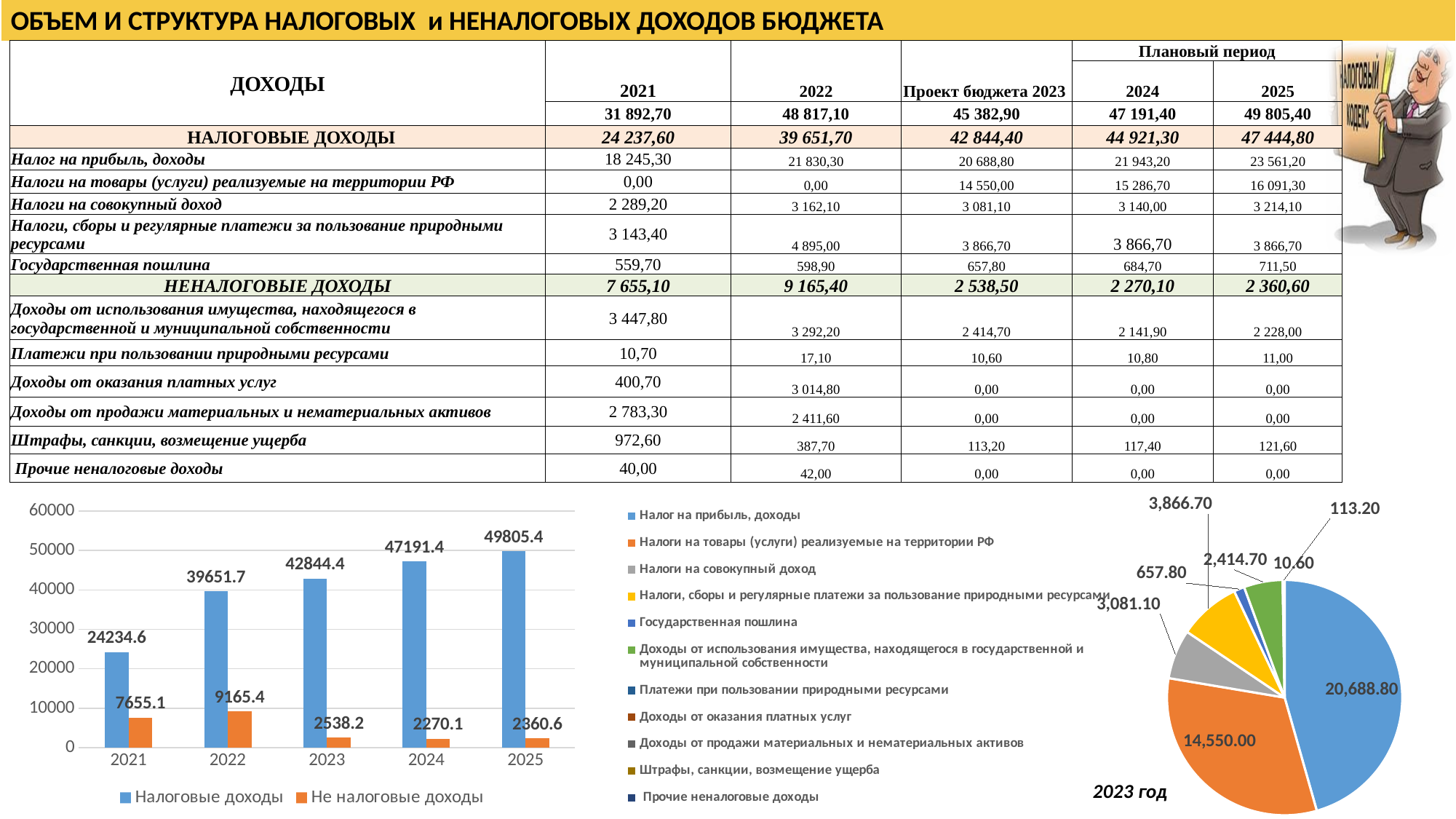
How many series does the legend of the bar chart list? 2 In the bar chart, what is the difference between Налоговые доходы and Не налоговые доходы in 2025? 47444.8 In the bar chart, is the value of Не налоговые доходы larger in 2021 or in 2022? 2022 In the pie chart, what is the value of the largest slice (Налог на прибыль, доходы)? 20,688.80 In the bar chart, is the value of Налоговые доходы for 2021 greater or less than 20000? greater In the bar chart, what is the value of Налоговые доходы for 2023? 42844.4 In the bar chart, do the values of Налоговые доходы rise or fall from 2021 to 2025? rise In the bar chart, which year has the lowest value for Не налоговые доходы? 2024 In the bar chart, which year has the highest value for Налоговые доходы? 2025 In the bar chart, what is the value of Не налоговые доходы for 2022? 9165.4 How many years are shown on the x axis of the bar chart? 5 What type of chart is the chart in the bottom left of the slide? bar chart